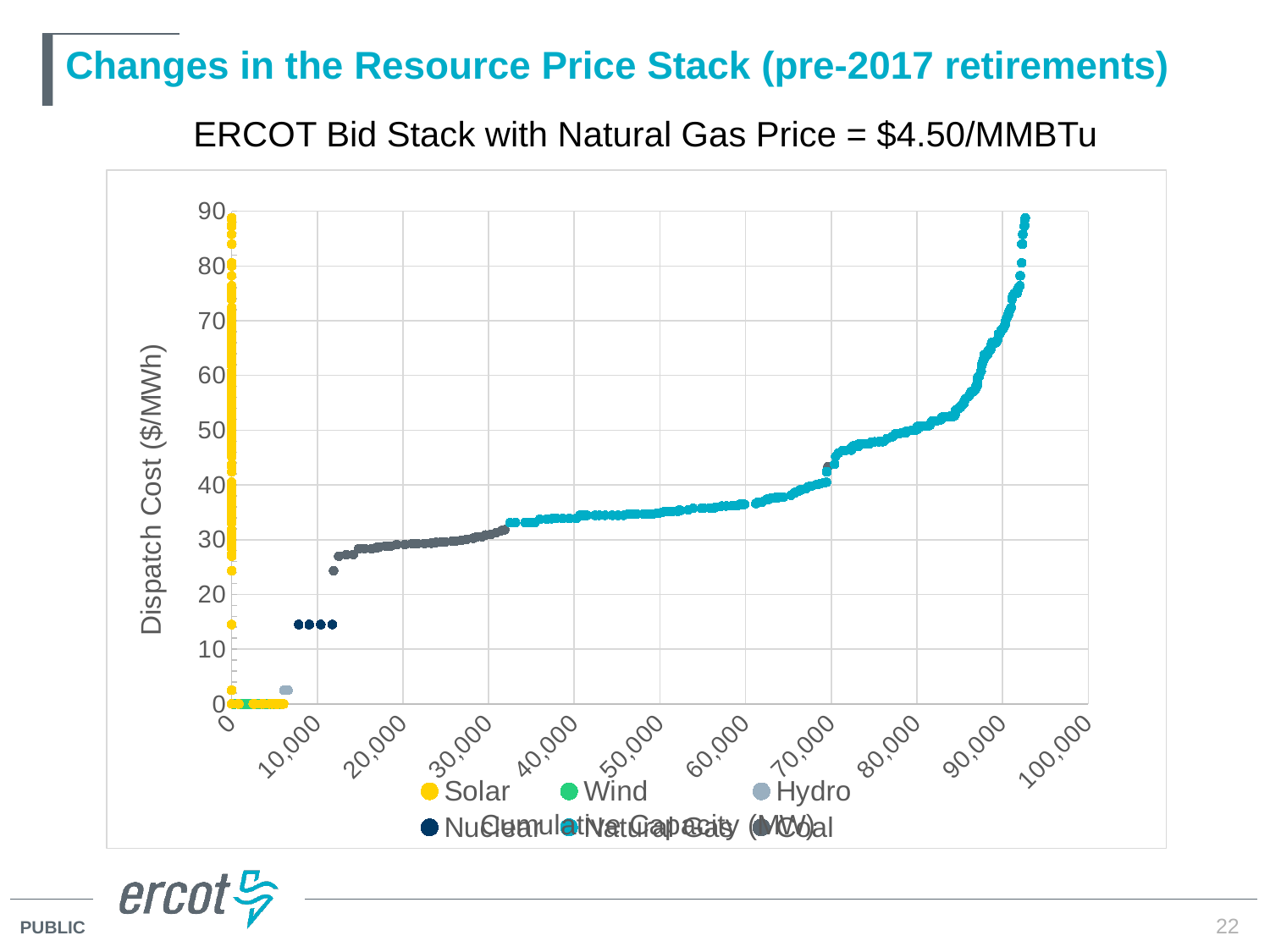
What kind of chart is shown on the slide? Scatter chart Which series extends to the highest cumulative capacity on the x axis? Natural Gas Is the dispatch cost of the Nuclear points greater or less than 20 $/MWh? less What is the label of the vertical axis? Dispatch Cost ($/MWh) How many series does the chart legend list? 6 What is the title of the chart? ERCOT Bid Stack with Natural Gas Price = $4.50/MMBTu Is the highest dispatch cost reached by the Natural Gas points greater or less than 80 $/MWh? greater Do the Natural Gas points rise or fall in dispatch cost as cumulative capacity increases? rise Is the dispatch cost of the Nuclear points greater or less than 10 $/MWh? greater Which has the higher dispatch cost, the Nuclear points or the Coal points? Coal